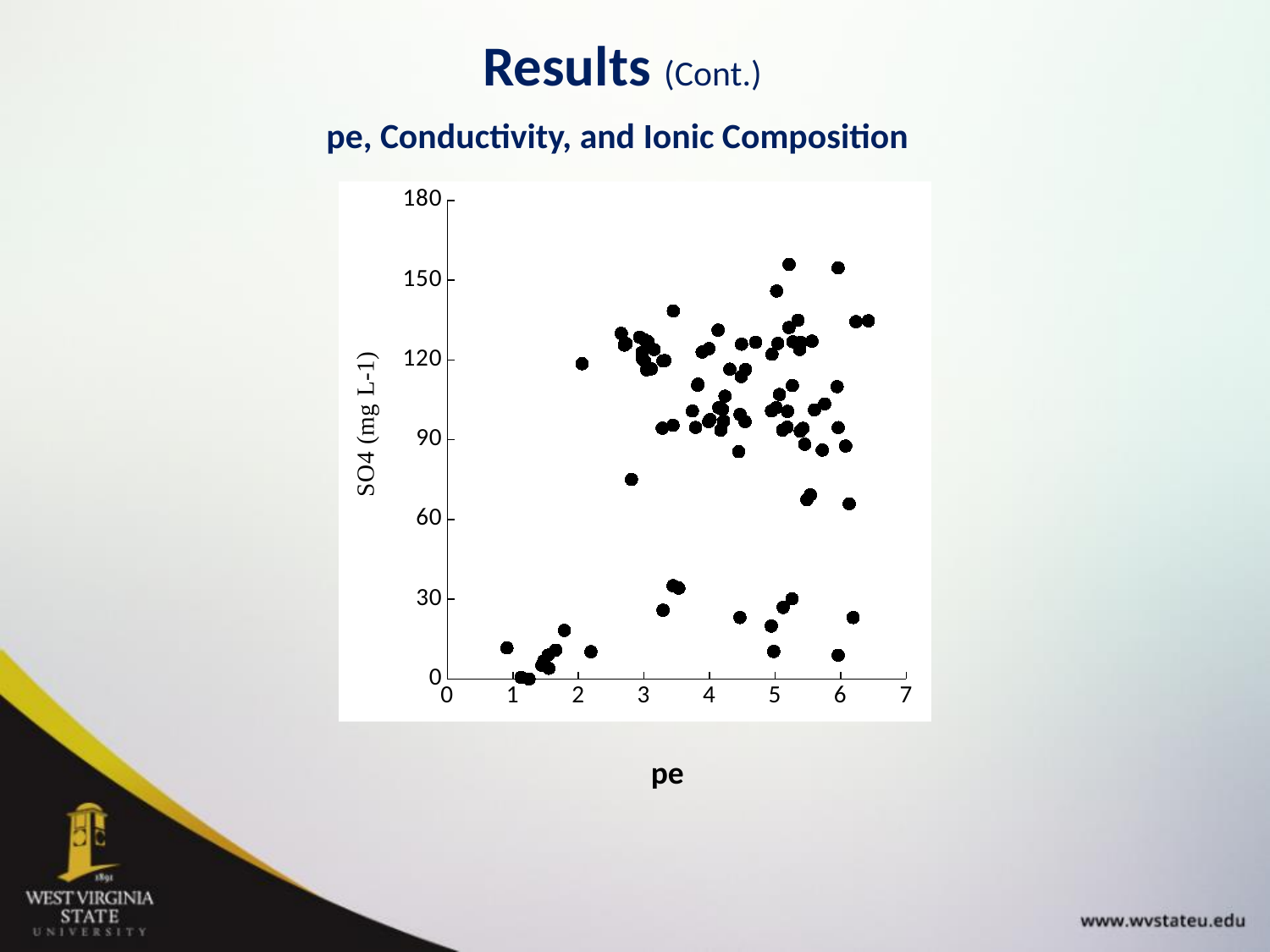
What kind of chart is shown on the slide? Scatter plot Do SO4 values generally rise or fall as pe increases along the x axis? rise Is the highest SO4 value plotted greater or less than 180? less Are the SO4 values for the points with pe below 2 greater or less than 30? less Is the highest SO4 value plotted on the chart greater or less than 150? greater What is the label of the x-axis of the chart? pe What is the label of the y-axis of the chart? SO4 (mg L-1)